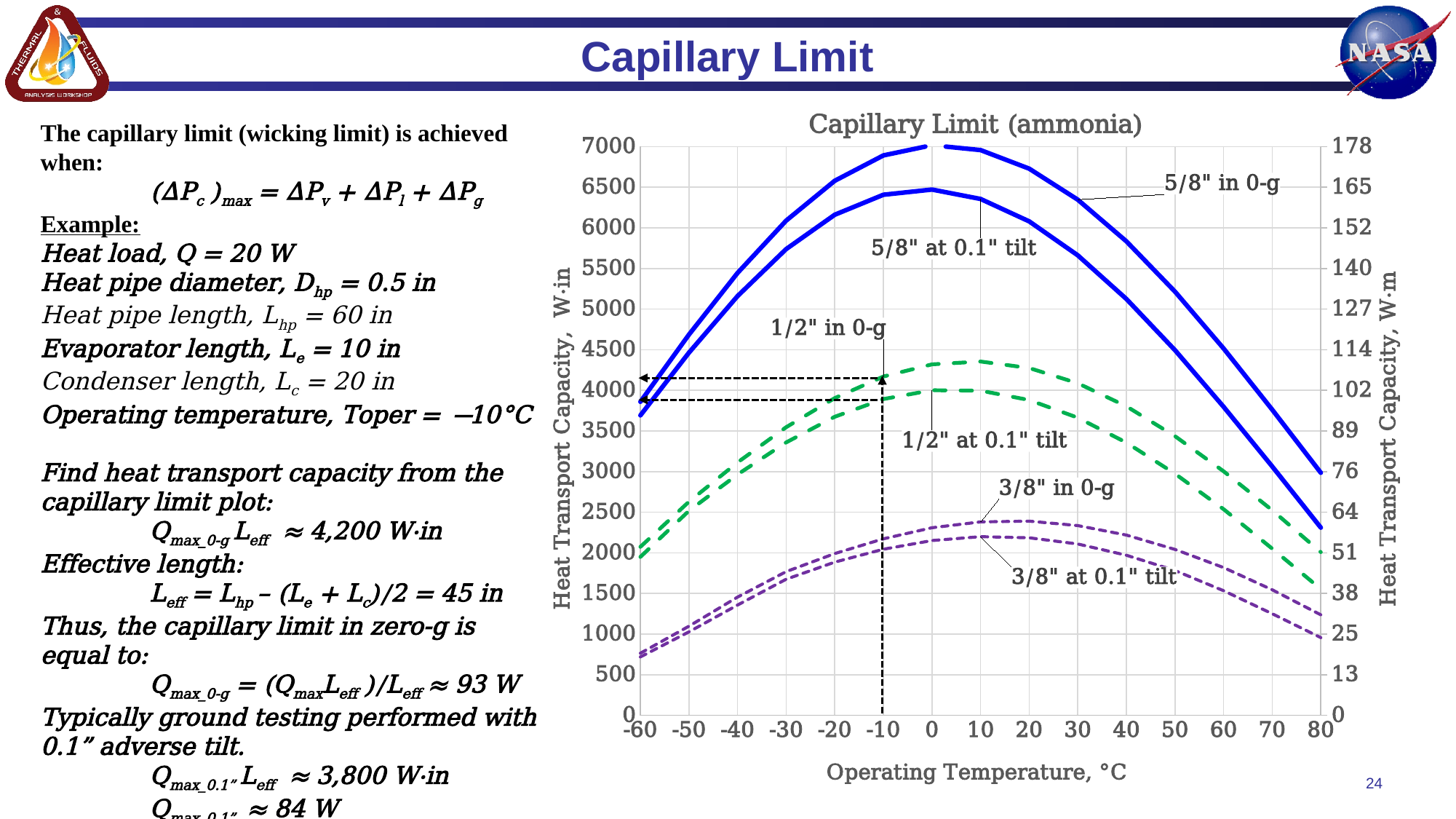
Is the value of the 3/8" in 0-g curve at 80 °C greater or less than 1500 W·in? less At 0 °C, which curve has the larger heat transport capacity: 5/8" in 0-g or 1/2" in 0-g? 5/8" in 0-g Is the value of the 1/2" in 0-g curve at 10 °C greater or less than 4000 W·in? greater Is the value of the 3/8" at 0.1" tilt curve at -60 °C greater or less than 1000 W·in? less What kind of chart is shown on the slide? Line chart Does the 5/8" in 0-g curve rise or fall as the operating temperature increases from 0 °C to 80 °C? Fall How many curves are plotted on the chart? 6 What is the label of the x axis of the chart? Operating Temperature, °C What is the title of the chart? Capillary Limit (ammonia) Which curve reaches the highest heat transport capacity on the chart? 5/8" in 0-g Which curve has the lowest heat transport capacity on the chart? 3/8" at 0.1" tilt